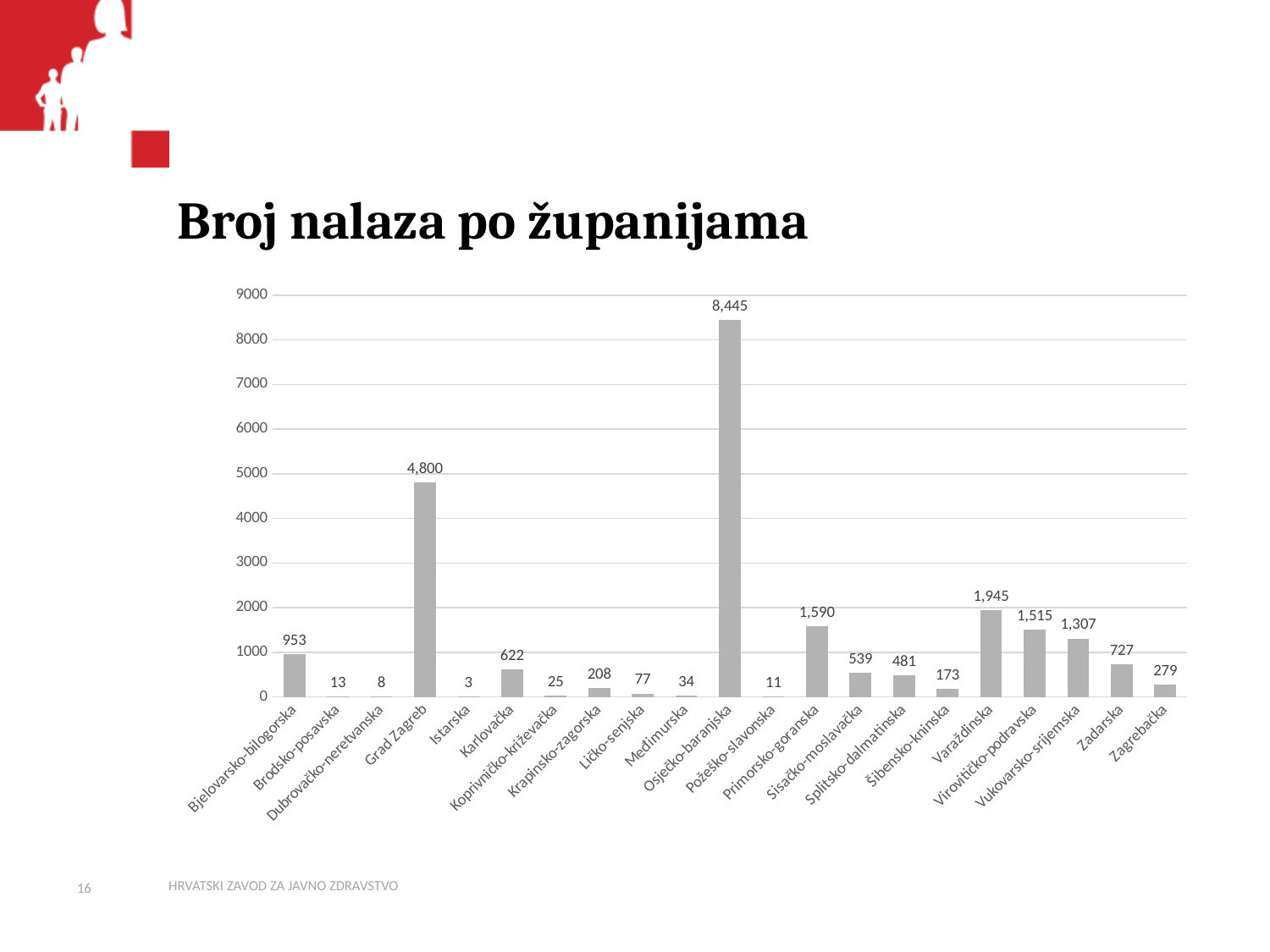
What is the value for Osječko-baranjska? 8,445 Which county has the highest number of findings? Osječko-baranjska What kind of chart is shown on the slide? bar chart Which county has the lowest number of findings? Istarska What is the value for Varaždinska? 1,945 What is the title of the chart? Broj nalaza po županijama What is the difference between the values for Osječko-baranjska and Grad Zagreb? 3,645 Which is larger, the value for Primorsko-goranska or the value for Virovitičko-podravska? Primorsko-goranska How many counties are shown on the chart? 21 Is the value for Zadarska greater or less than 1000? less What is the value for Grad Zagreb? 4,800 What is the value for Istarska? 3